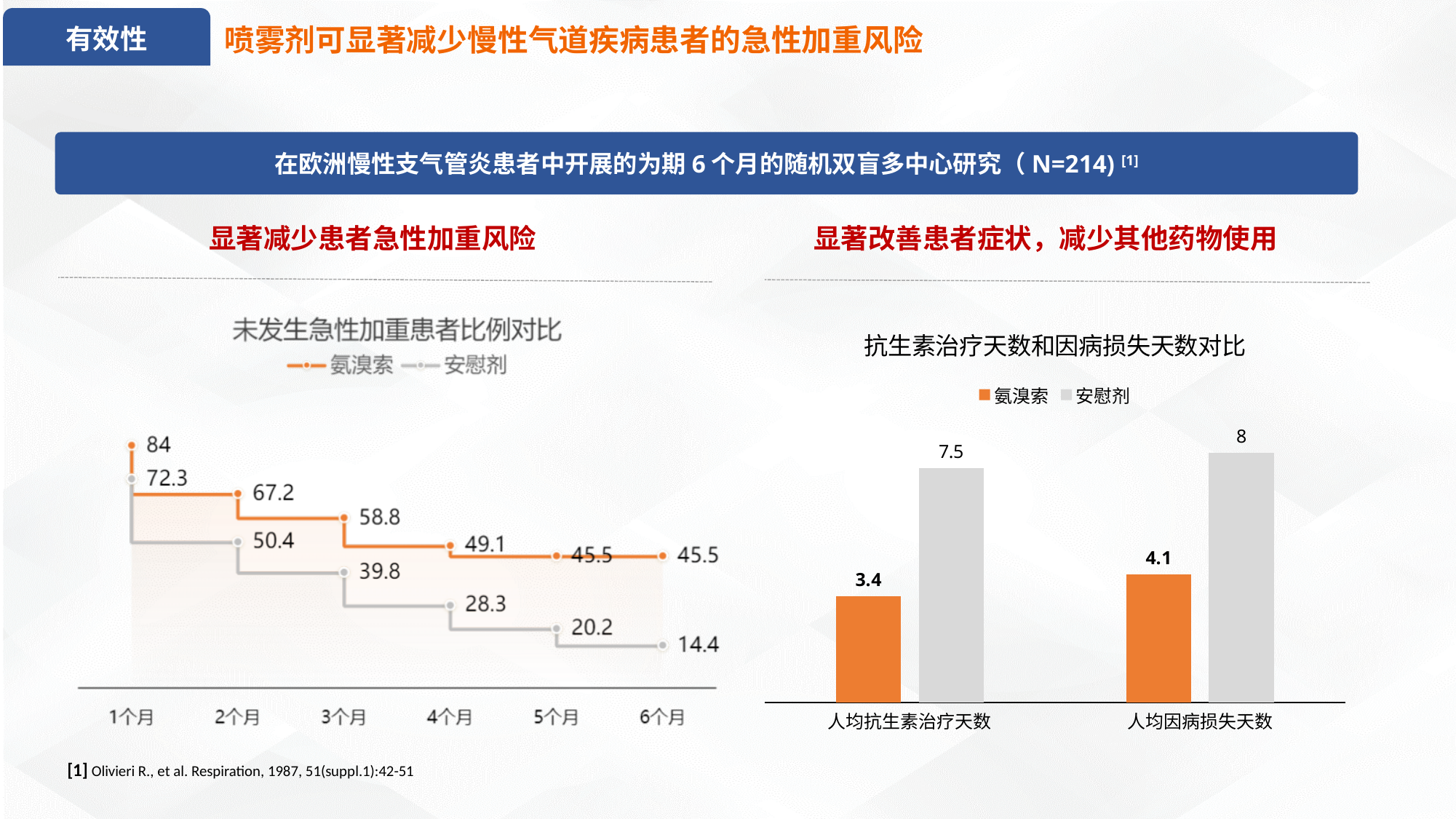
What kind of chart is the chart titled 抗生素治疗天数和因病损失天数对比? bar chart In the chart titled 未发生急性加重患者比例对比, how many time points are shown on the x axis? 6 In the chart titled 未发生急性加重患者比例对比, what is the value for 安慰剂 at 6个月? 14.4 In the chart titled 未发生急性加重患者比例对比, what is the value for 安慰剂 at 3个月? 39.8 In the chart titled 抗生素治疗天数和因病损失天数对比, what is the value for 安慰剂 in 人均因病损失天数? 8 In the chart titled 抗生素治疗天数和因病损失天数对比, what is the value for 氨溴索 in 人均抗生素治疗天数? 3.4 In the chart titled 未发生急性加重患者比例对比, at which month is the value for 氨溴索 lowest? 5个月 and 6个月 (45.5) In the chart titled 未发生急性加重患者比例对比, what is the value for 氨溴索 at 1个月? 84 In the chart titled 未发生急性加重患者比例对比, do the values for 安慰剂 rise or fall from 1个月 to 6个月? fall In the chart titled 未发生急性加重患者比例对比, what is the difference between 氨溴索 and 安慰剂 at 6个月? 31.1 In the chart titled 抗生素治疗天数和因病损失天数对比, which series has the larger value in 人均因病损失天数? 安慰剂 In the chart titled 抗生素治疗天数和因病损失天数对比, what is the difference between 安慰剂 and 氨溴索 in 人均抗生素治疗天数? 4.1